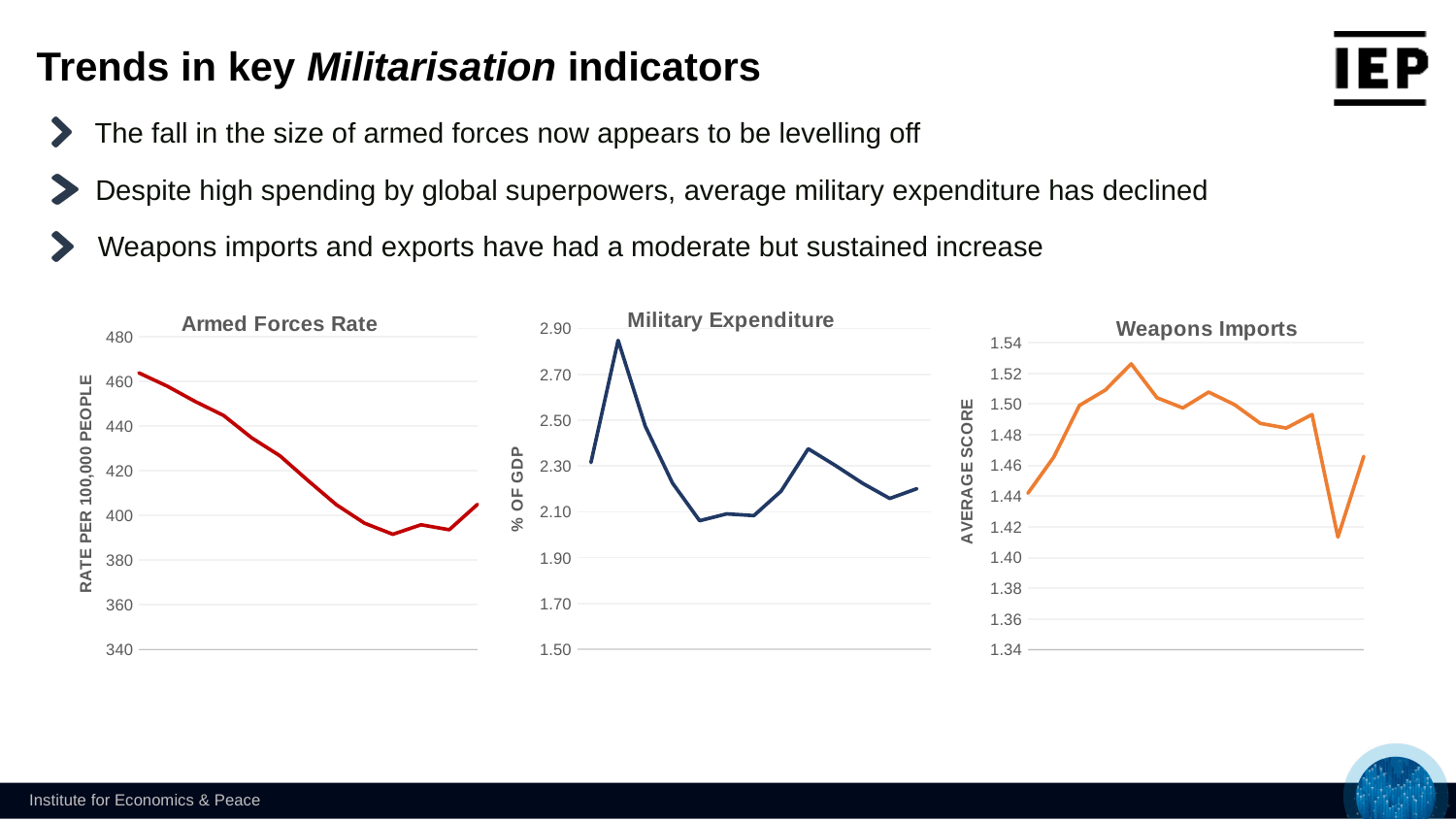
In the Armed Forces Rate chart, does the line overall rise or fall from left to right? Fall In the Military Expenditure chart, does the line overall rise or fall from its peak to the final point? Fall In the Armed Forces Rate chart, is the first (leftmost) value greater or less than 440? greater What is the y-axis label of the Military Expenditure chart? % OF GDP How many charts are shown on the slide? 3 What kind of chart is the Armed Forces Rate chart? Line chart In the Military Expenditure chart, is the highest point on the line greater or less than 2.70? greater In the Military Expenditure chart, is the final (rightmost) value greater or less than 2.30? less What kind of chart is the Weapons Imports chart? Line chart